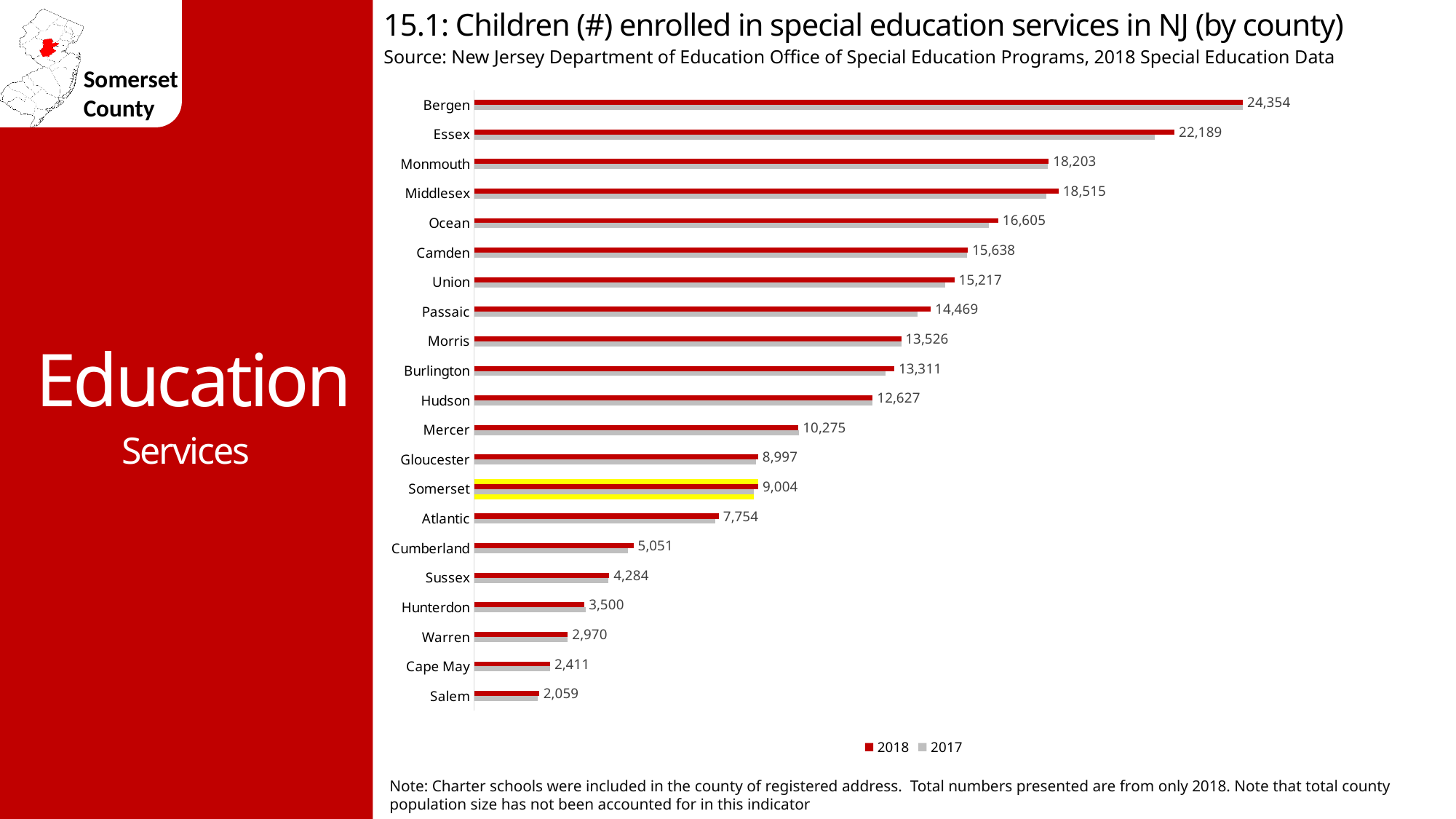
How many children were enrolled in special education services in Somerset County in 2018? 9,004 Which county's bars are highlighted in yellow on the chart? Somerset What is the 2018 value shown for Hunterdon County? 3,500 What is the difference between the 2018 values for Middlesex and Monmouth? 312 How many series does the legend list? 2 Which county has the highest number of children enrolled in special education services in 2018? Bergen Which county had more children enrolled in 2018, Ocean or Camden? Ocean Which county has the lowest number of children enrolled in special education services in 2018? Salem How many counties are shown on the chart? 21 What is the difference between the 2018 values for Bergen and Essex? 2,165 What is the 2018 value shown for Bergen County? 24,354 What type of chart is shown on the slide? Bar chart